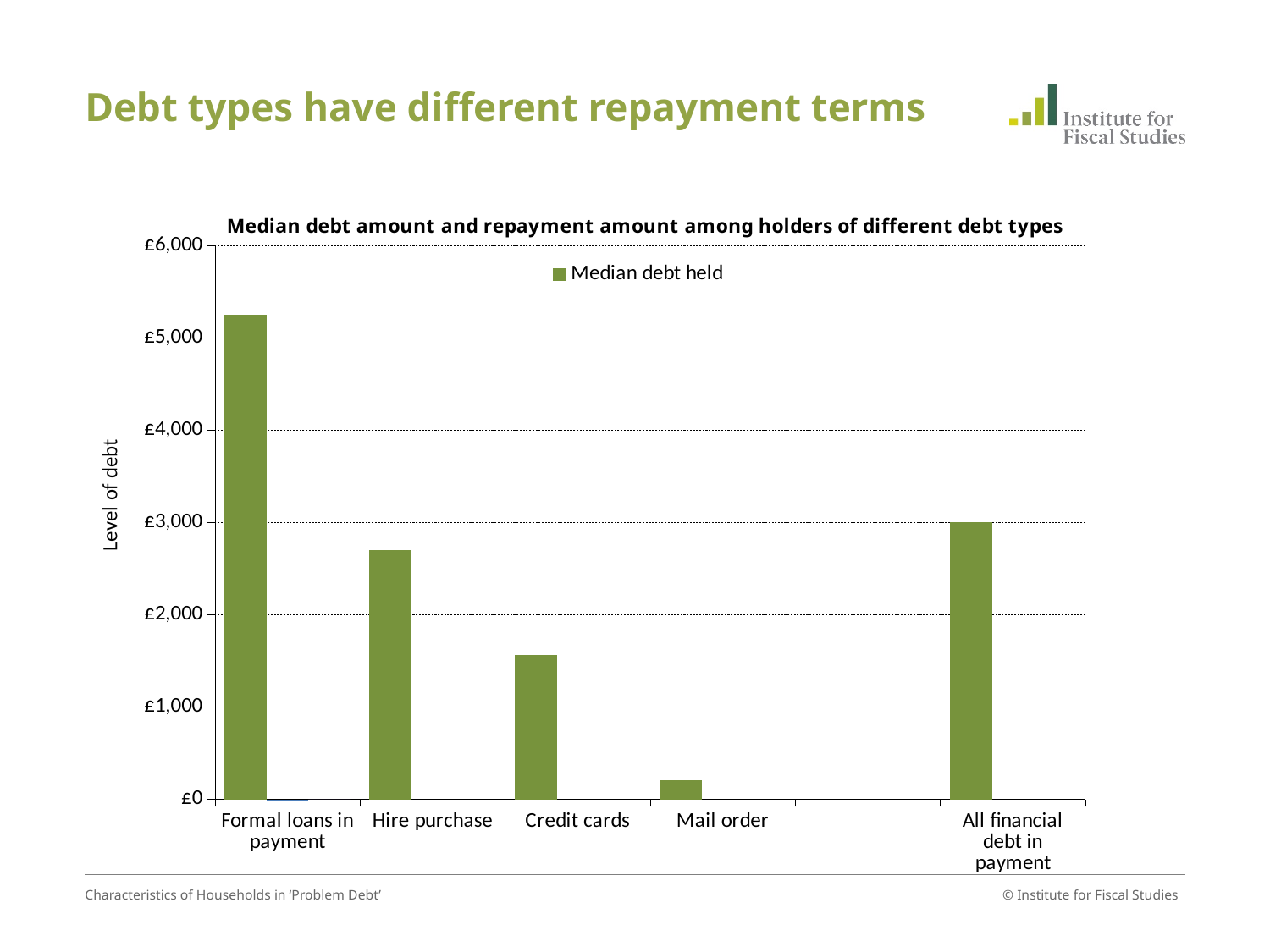
Which debt type has the lowest median debt held? Mail order How many bars are plotted in the chart? 5 How many series does the legend list? 1 Which has a higher median debt held, Hire purchase or Credit cards? Hire purchase Is the median debt held for Formal loans in payment greater or less than £5,000? greater Is the median debt held for Credit cards greater or less than £1,000? greater Is the median debt held for Hire purchase greater or less than £3,000? less Which has a higher median debt held, All financial debt in payment or Hire purchase? All financial debt in payment Which debt type has the highest median debt held? Formal loans in payment What kind of chart is shown on the slide? bar chart What is the label of the series shown in the legend? Median debt held